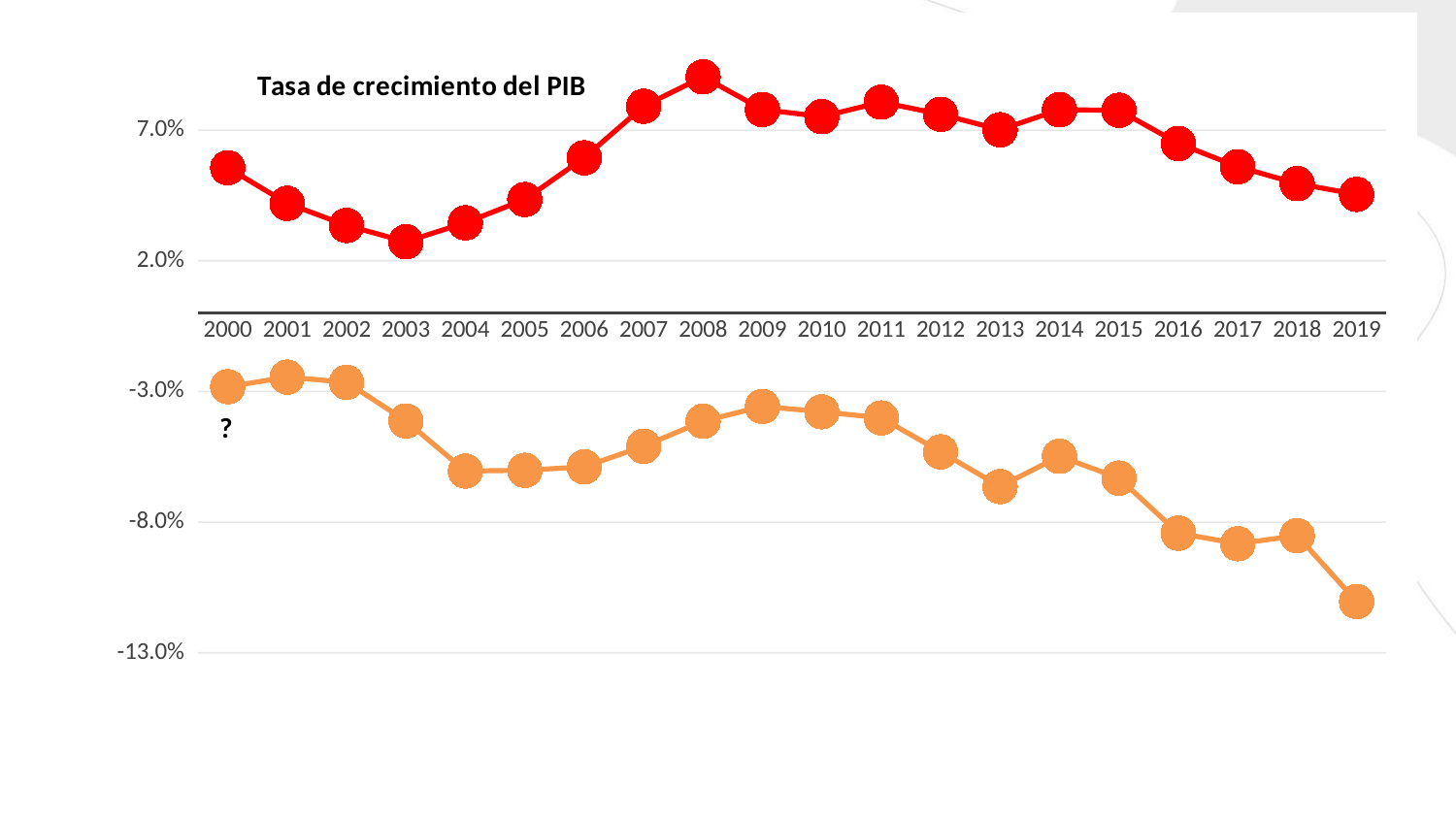
Is the value of the orange line in 2009 greater or less than -8.0%? greater How many lines (series) are plotted on the chart? 2 What label is shown next to the start of the orange line? ? Is the value of the orange line in 2019 greater or less than -8.0%? less Which is larger for the red 'Tasa de crecimiento del PIB' line: the value in 2000 or the value in 2003? 2000 How many years are plotted along the x axis? 20 Does the orange line rise or fall between 2015 and 2019? Fall What kind of chart is shown on the slide? Line chart In which year does the red 'Tasa de crecimiento del PIB' line reach its highest value? 2008 Is the value of the red 'Tasa de crecimiento del PIB' line in 2008 greater or less than 7.0%? greater In which year does the red 'Tasa de crecimiento del PIB' line reach its lowest value? 2003 In which year does the orange line reach its lowest value? 2019